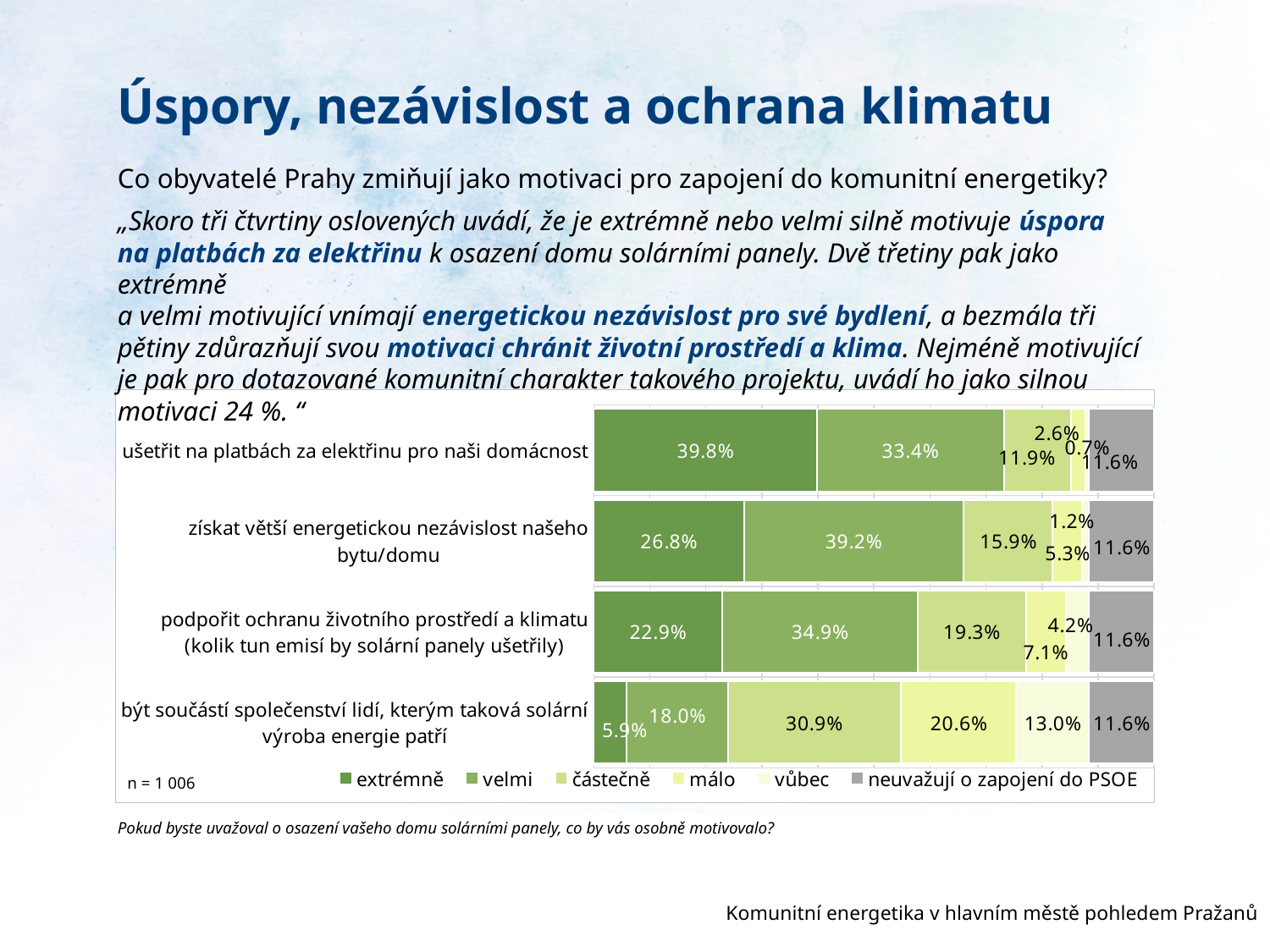
Which category has the lowest 'extrémně' value? být součástí společenství lidí, kterým taková solární výroba energie patří What kind of chart is shown on the slide? stacked bar chart What is the 'vůbec' value for 'podpořit ochranu životního prostředí a klimatu'? 4.2% Which is larger: the 'velmi' value for 'podpořit ochranu životního prostředí a klimatu' or the 'velmi' value for 'být součástí společenství lidí, kterým taková solární výroba energie patří'? podpořit ochranu životního prostředí a klimatu What is the 'velmi' value for 'získat větší energetickou nezávislost našeho bytu/domu'? 39.2% What is the difference between the 'extrémně' values for 'ušetřit na platbách za elektřinu pro naši domácnost' and 'získat větší energetickou nezávislost našeho bytu/domu'? 13.0% What is the 'extrémně' value for 'ušetřit na platbách za elektřinu pro naši domácnost'? 39.8% Which category has the highest 'extrémně' value? ušetřit na platbách za elektřinu pro naši domácnost What is the 'částečně' value for 'být součástí společenství lidí, kterým taková solární výroba energie patří'? 30.9% What is the sample size (n) shown on the chart? n = 1 006 How many series does the legend list? 6 How many categories (motivations) are plotted in the chart? 4